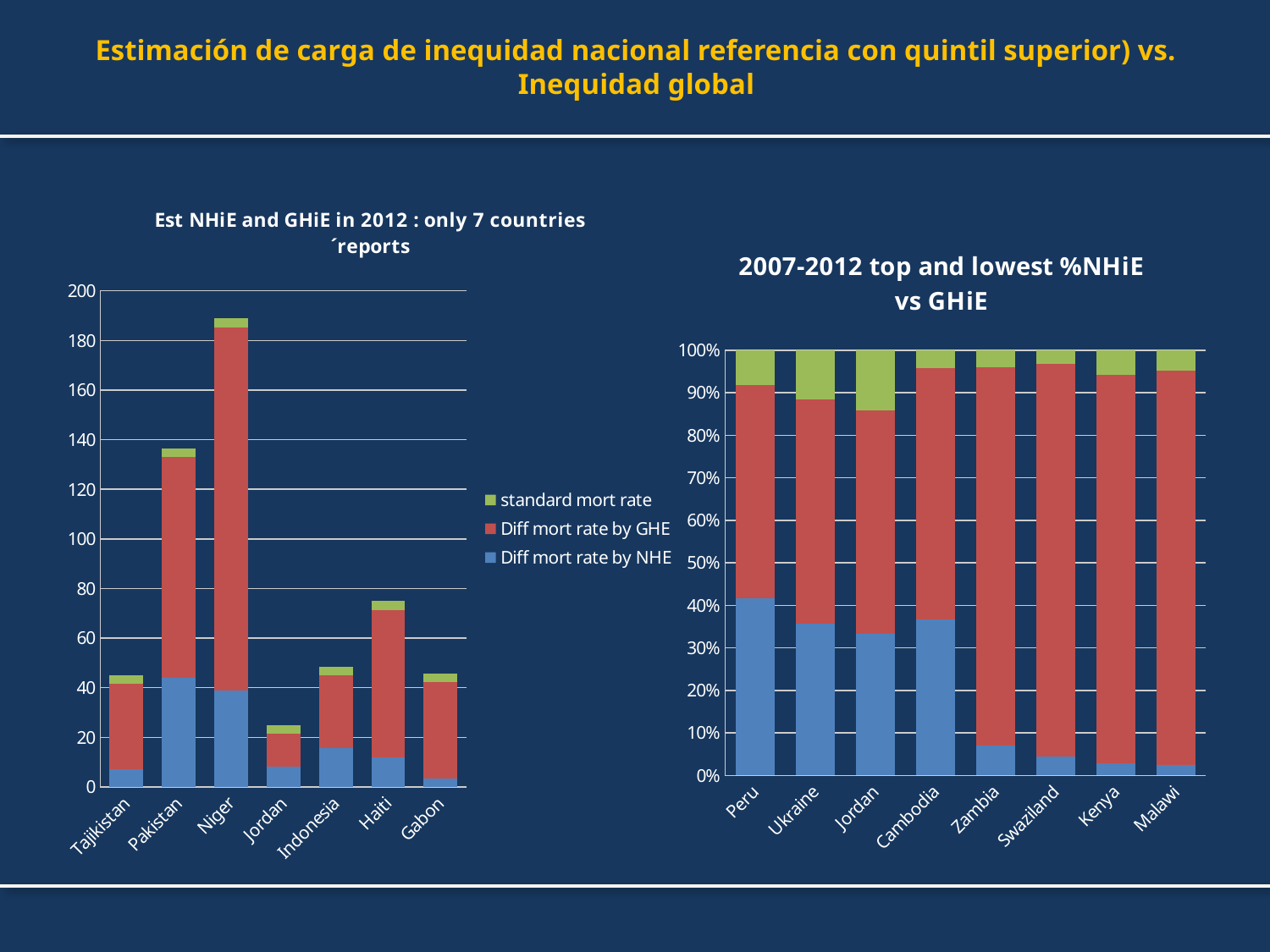
What kind of chart is the left chart titled 'Est NHiE and GHiE in 2012'? Stacked bar chart In the right chart titled '2007-2012 top and lowest %NHiE vs GHiE', how many countries are shown on the x axis? 8 In the left chart titled 'Est NHiE and GHiE in 2012', which country has the shortest stacked bar? Jordan In the left chart titled 'Est NHiE and GHiE in 2012', how many countries are shown on the x axis? 7 In the left chart titled 'Est NHiE and GHiE in 2012', is the total stacked bar for Jordan greater or less than 40? less In the right chart titled '2007-2012 top and lowest %NHiE vs GHiE', which country has the largest blue segment? Peru In the left chart titled 'Est NHiE and GHiE in 2012', which country has the tallest stacked bar? Niger In the left chart titled 'Est NHiE and GHiE in 2012', is the total stacked bar for Niger greater or less than 180? greater In the right chart titled '2007-2012 top and lowest %NHiE vs GHiE', is the blue segment for Ukraine greater or less than 30%? greater In the left chart titled 'Est NHiE and GHiE in 2012', which has the taller stacked bar, Pakistan or Haiti? Pakistan In the left chart titled 'Est NHiE and GHiE in 2012', how many series does the legend list? 3 In the left chart titled 'Est NHiE and GHiE in 2012', which series is shown in green according to the legend? standard mort rate